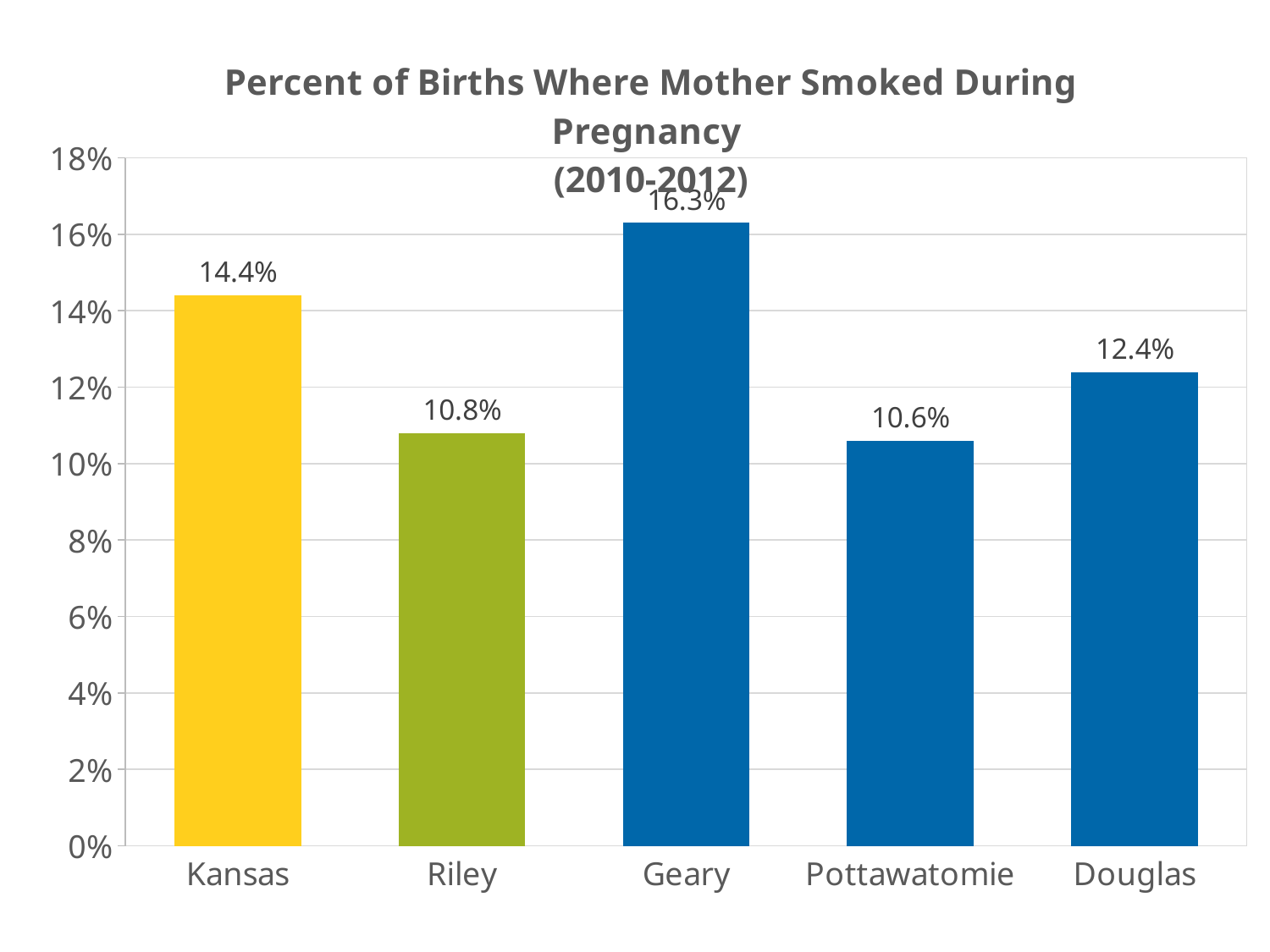
What is the title of the chart? Percent of Births Where Mother Smoked During Pregnancy (2010-2012) What is the value for Douglas? 12.4% Which is larger, the value for Douglas or the value for Riley? Douglas How many categories are shown on the x axis? 5 What is the value for Pottawatomie? 10.6% What kind of chart is shown on the slide? bar chart Which category has the highest value? Geary Is the value for Pottawatomie greater or less than 12%? less What is the value for Geary? 16.3% What is the value for Riley? 10.8% What is the difference between the values for Geary and Kansas? 1.9% What is the value for Kansas? 14.4%